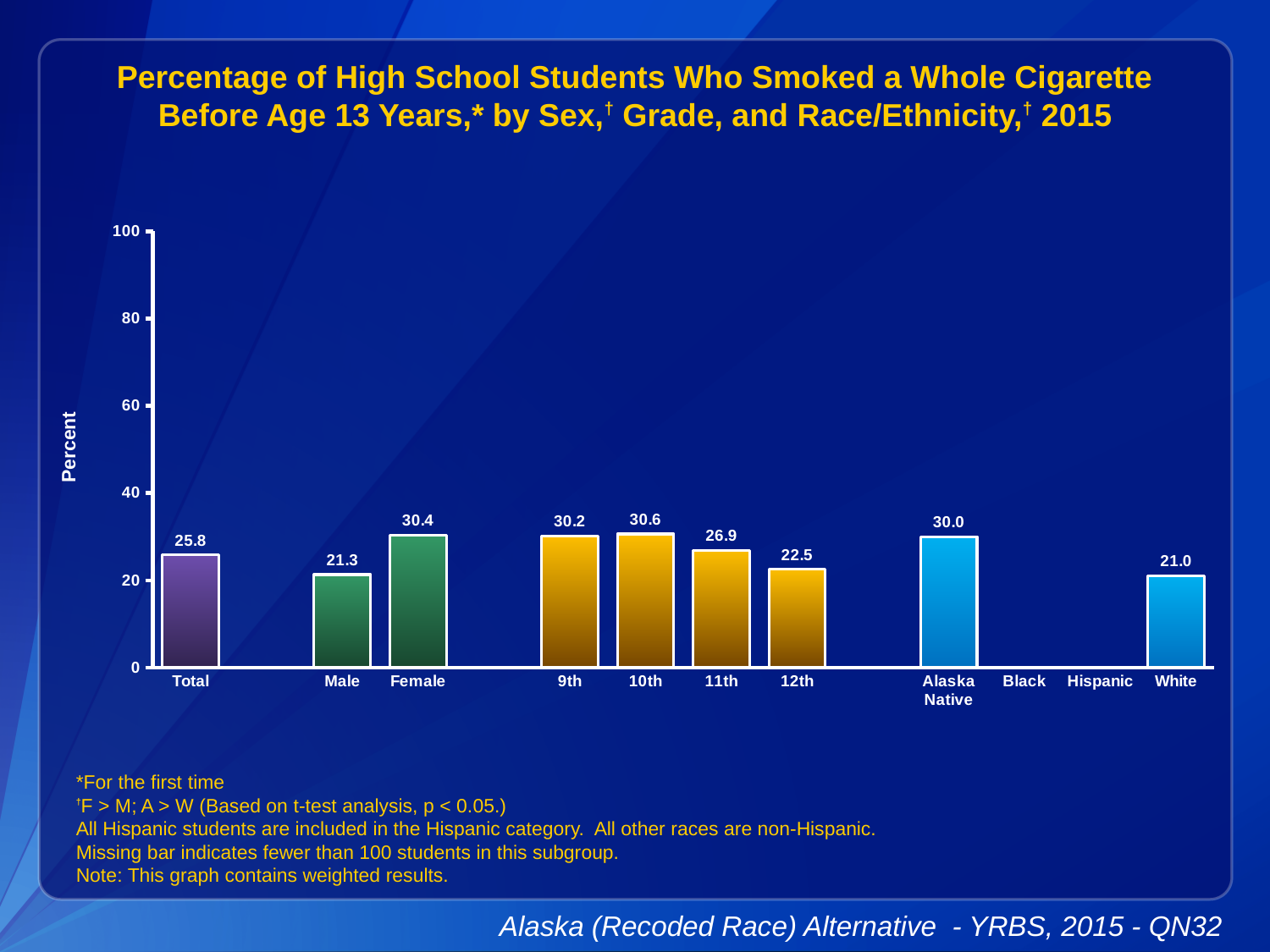
How many categories have a bar plotted? 9 What is the value for Alaska Native? 30.0 What is the value for 12th grade? 22.5 What is the value for Total? 25.8 What is the label of the y axis? Percent What kind of chart is shown? bar chart Which category with a bar has the lowest value? White Which is larger, the value for 9th grade or 11th grade? 9th What is the value for Female? 30.4 Which category has the highest value? 10th Is the value for Male greater or less than 40? less What is the difference between the Female and Male values? 9.1